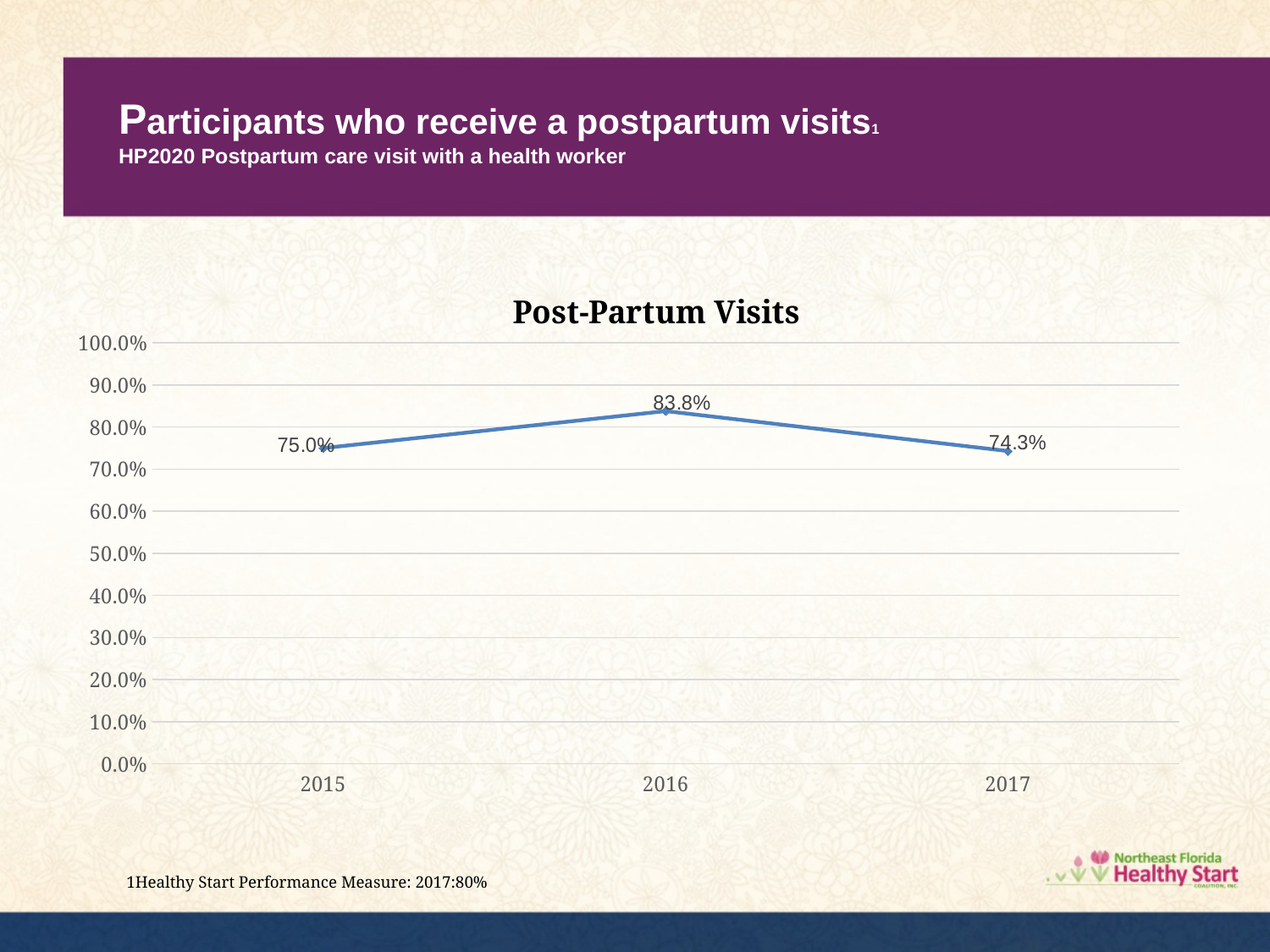
Which year has the lowest value? 2017 What is the value for 2016? 83.8% How many years are plotted on the chart? 3 Which is larger, the value for 2015 or the value for 2017? 2015 Which year has the highest value? 2016 What is the value for 2015? 75.0% What is the difference between the values for 2016 and 2017? 9.5% What is the title of the chart? Post-Partum Visits What is the value for 2017? 74.3% Is the value for 2016 greater or less than 80.0%? greater What kind of chart is shown? line chart What is the difference between the values for 2016 and 2015? 8.8%